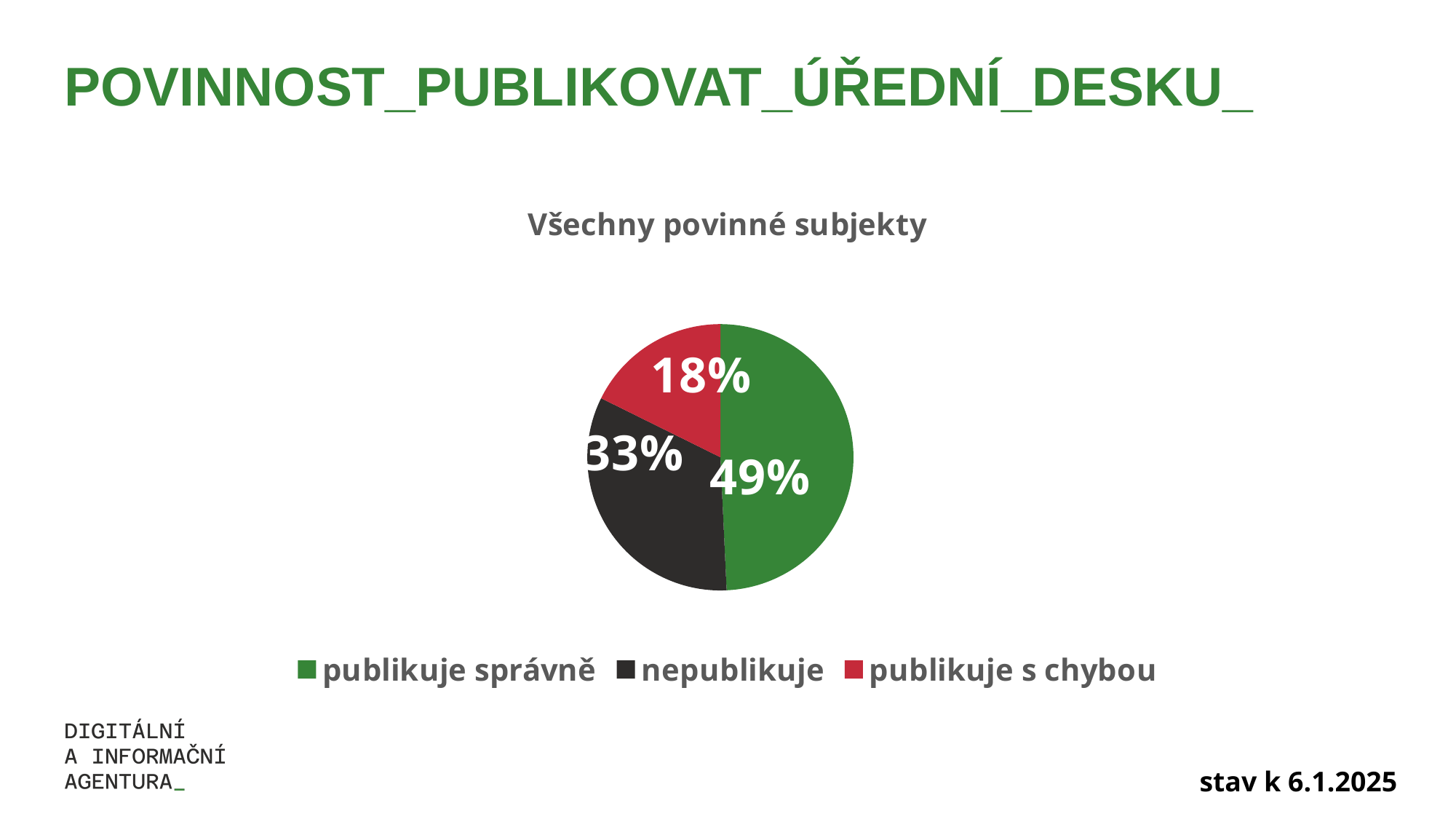
What share of the pie does 'publikuje správně' represent? 49% Which category has the smallest share of the pie? publikuje s chybou What colour is the slice for 'publikuje s chybou'? red What share of the pie does 'nepublikuje' represent? 33% How many categories does the pie chart have? 3 What is the difference in percentage points between 'nepublikuje' and 'publikuje s chybou'? 15 What share of the pie does 'publikuje s chybou' represent? 18% What type of chart is shown on the slide? pie chart Which is larger, the share for 'nepublikuje' or for 'publikuje s chybou'? nepublikuje Which category has the largest share of the pie? publikuje správně What is the difference in percentage points between 'publikuje správně' and 'nepublikuje'? 16 What is the title of the chart? Všechny povinné subjekty